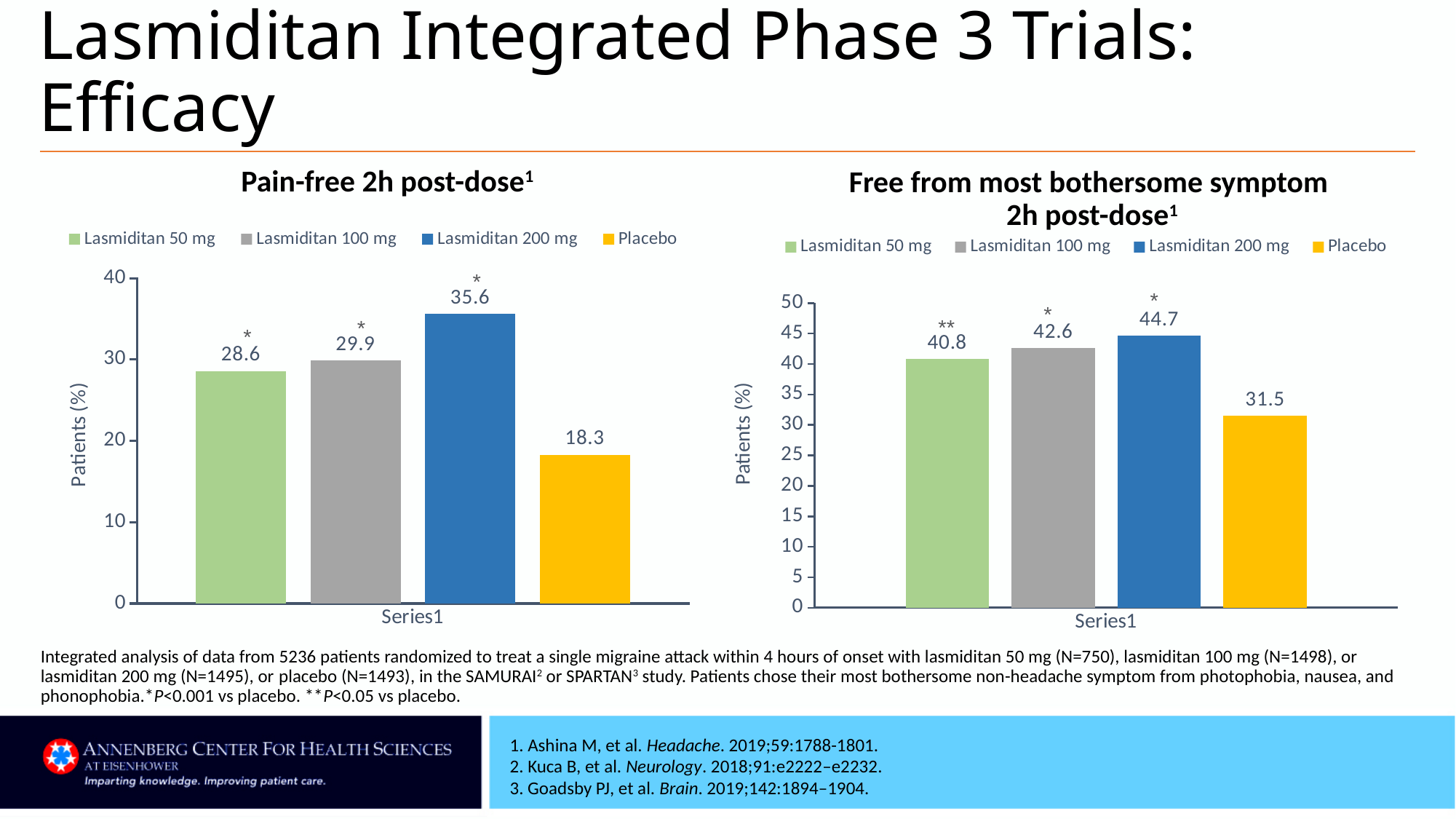
In the 'Free from most bothersome symptom 2h post-dose' chart, what is the value for Placebo? 31.5 In the 'Pain-free 2h post-dose' chart, what is the value for Lasmiditan 200 mg? 35.6 In the 'Free from most bothersome symptom 2h post-dose' chart, what is the value for Lasmiditan 50 mg? 40.8 In the 'Pain-free 2h post-dose' chart, which series has the highest value? Lasmiditan 200 mg In the 'Free from most bothersome symptom 2h post-dose' chart, which series has the lowest value? Placebo In the 'Free from most bothersome symptom 2h post-dose' chart, what is the difference between Lasmiditan 200 mg and Lasmiditan 100 mg? 2.1 What kind of chart is the 'Pain-free 2h post-dose' chart? Bar chart How many series does the legend of the 'Free from most bothersome symptom 2h post-dose' chart list? 4 In the 'Pain-free 2h post-dose' chart, which is larger: Lasmiditan 100 mg or Placebo? Lasmiditan 100 mg In the 'Pain-free 2h post-dose' chart, what is the value for Placebo? 18.3 What is the y-axis label of the 'Pain-free 2h post-dose' chart? Patients (%) In the 'Pain-free 2h post-dose' chart, what is the difference between Lasmiditan 200 mg and Placebo? 17.3